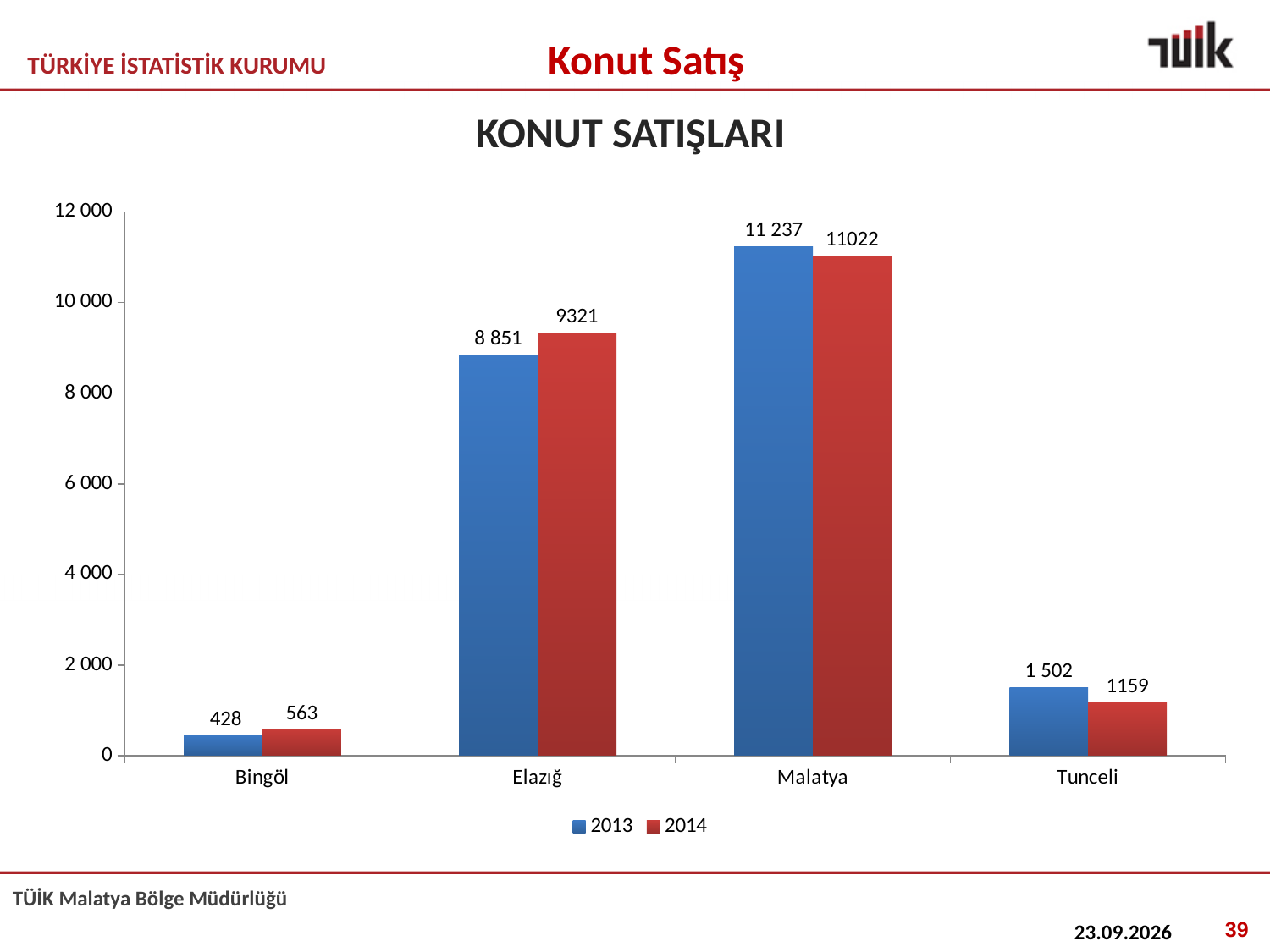
Which province had the lowest housing sales in 2013? Bingöl What was the number of housing sales in Bingöl in 2014? 563 Which province had the highest housing sales in 2014? Malatya How many series does the legend list? 2 What was the number of housing sales in Tunceli in 2013? 1 502 What was the number of housing sales in Elazığ in 2013? 8 851 What is the difference between Elazığ's 2014 and 2013 housing sales? 470 What type of chart is shown on the slide? Bar chart What is the difference between Malatya's 2013 and 2014 housing sales? 215 Which is larger for Tunceli: housing sales in 2013 or in 2014? 2013 How many provinces are shown on the x axis of the chart? 4 What was the number of housing sales in Malatya in 2014? 11022